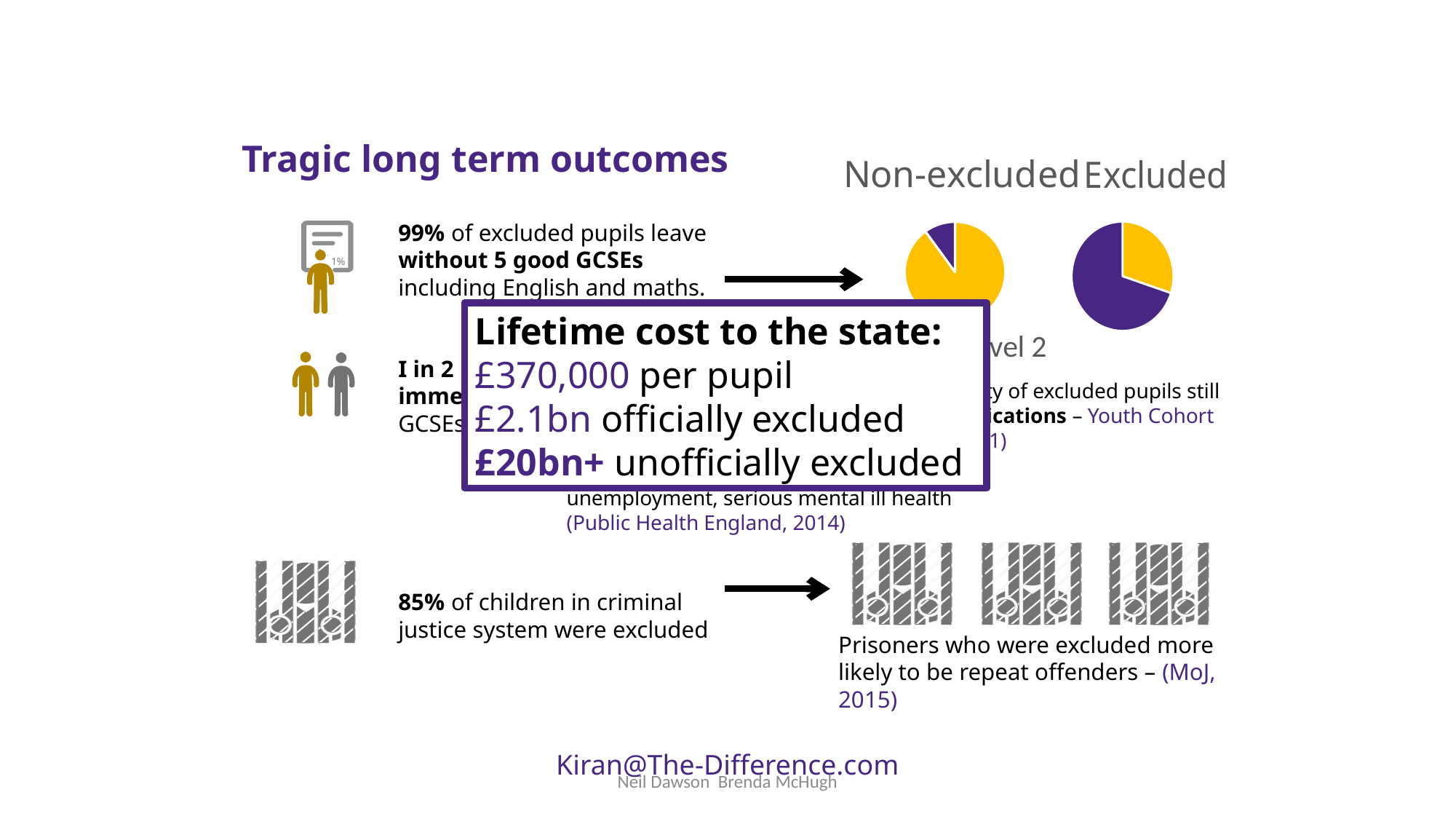
Which pie chart has the larger purple slice, Non-excluded or Excluded? Excluded How many pie charts are shown on the slide? 2 In the Excluded pie chart, which slice is larger, the yellow one or the purple one? purple What kind of chart is used for the Non-excluded and Excluded visuals on the right of the slide? pie chart What is the label above the right pie chart? Excluded In the Non-excluded pie chart, which slice is larger, the yellow one or the purple one? yellow What is the label above the left pie chart? Non-excluded How many slices does the Non-excluded pie chart have? 2 How many slices does the Excluded pie chart have? 2